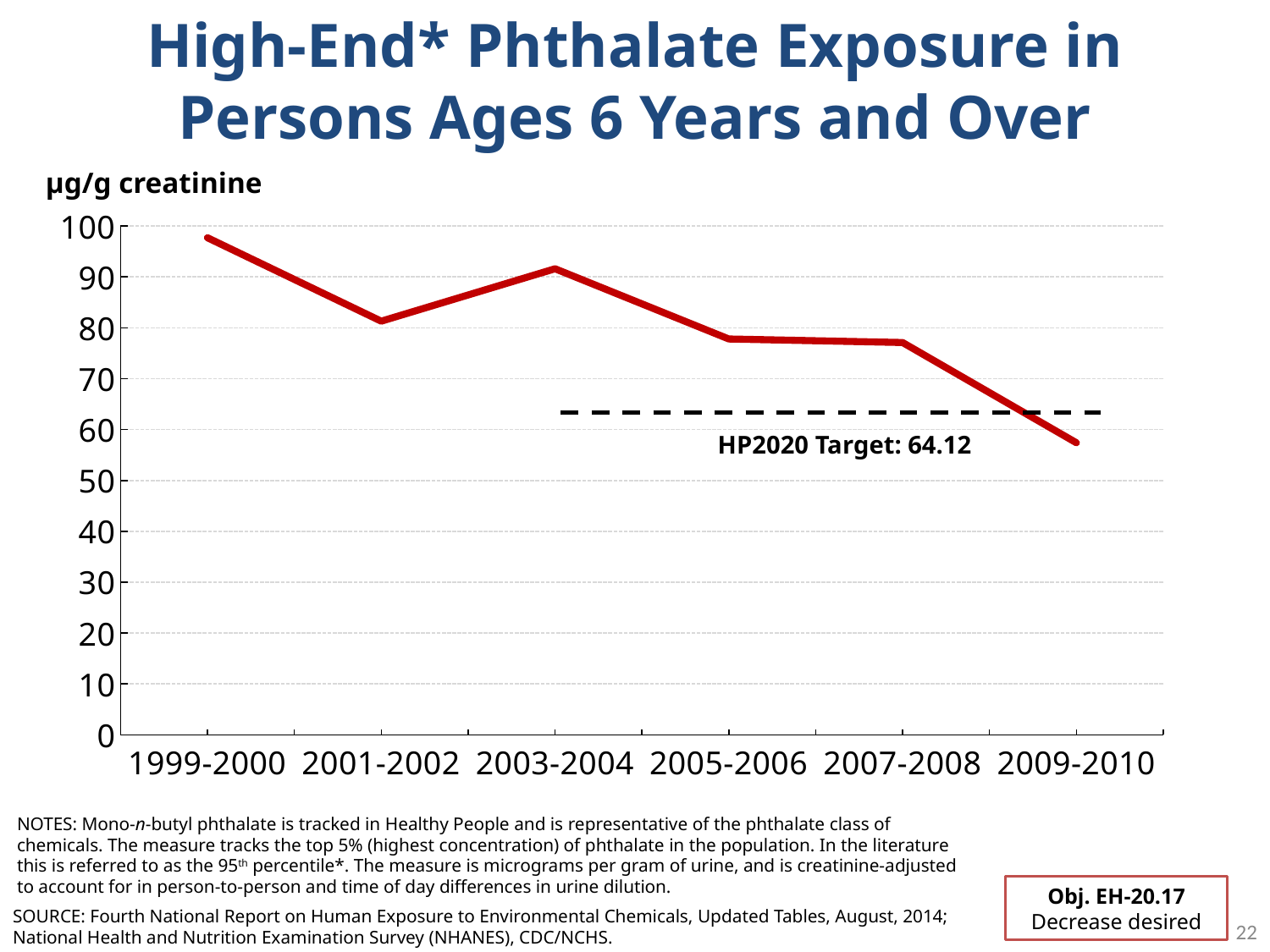
Is the value for 2009-2010 greater or less than 60? less Is the value for 1999-2000 greater or less than 90? greater What unit is shown on the y axis of the chart? µg/g creatinine Which time period has the lowest high-end phthalate exposure? 2009-2010 How many time periods are plotted along the x axis? 6 Which is larger, the value for 2001-2002 or the value for 2003-2004? 2003-2004 What kind of chart is shown on the slide? line chart Overall, do the values rise or fall from 1999-2000 to 2009-2010? fall What objective number is shown in the box at the bottom right of the slide? Obj. EH-20.17 What is the HP2020 Target value shown on the chart? 64.12 Which time period has the highest high-end phthalate exposure? 1999-2000 Is the value for 2005-2006 greater or less than 70? greater